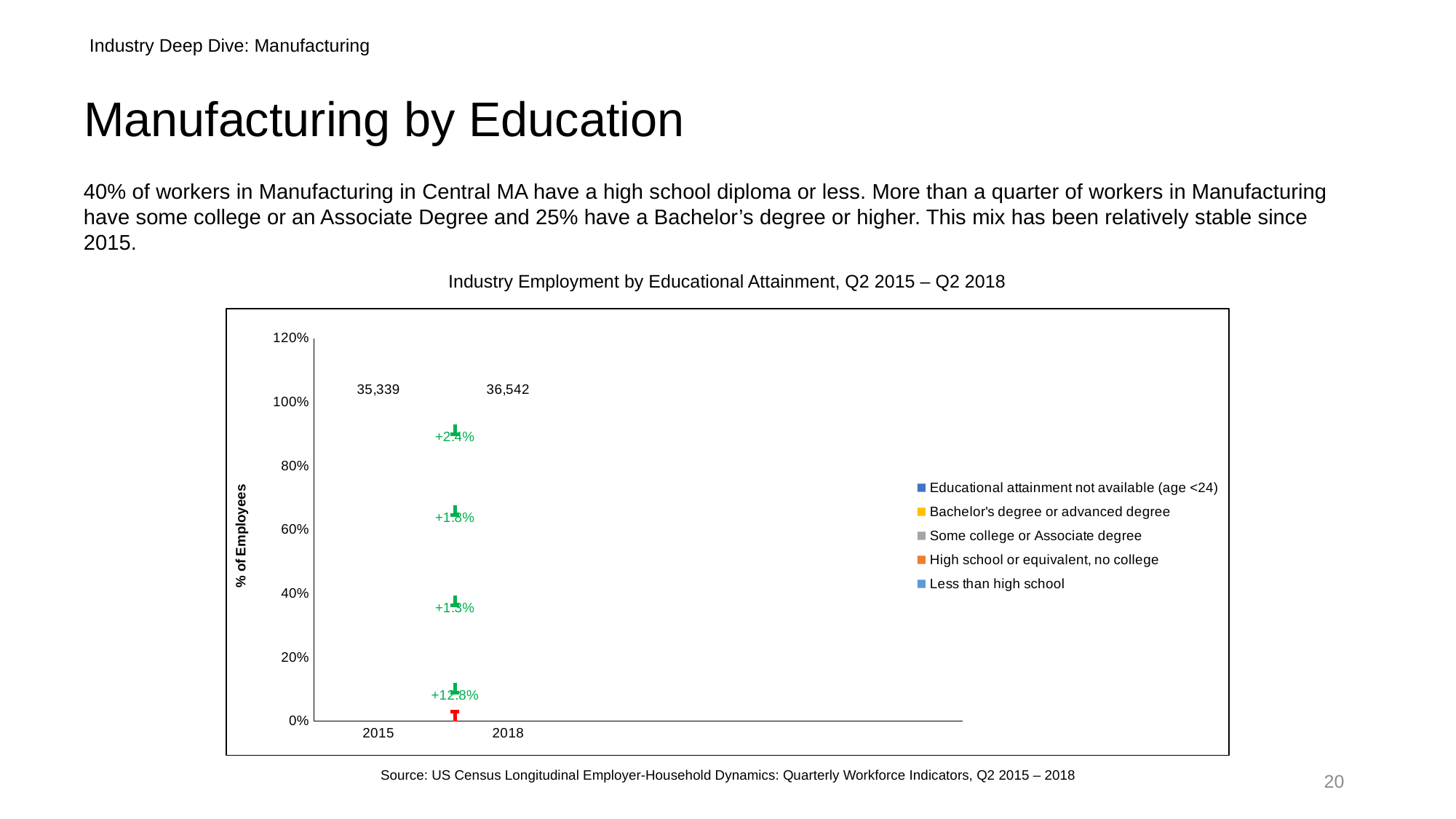
What is the first entry listed in the legend? Educational attainment not available (age <24) What total is printed above the 2018 bar? 36,542 What percentage change is printed in green nearest the top of the chart? +2.4% What percentage change is printed in green nearest the bottom of the chart? +12.8% What total is printed above the 2015 bar? 35,339 What is the label on the y axis? % of Employees What is the difference between the printed totals for 2018 and 2015? 1,203 Which year has the larger printed total, 2015 or 2018? 2018 How many series does the legend list? 5 How many years are shown on the x axis? 2 Which of the green percentage-change annotations is the largest? +12.8%